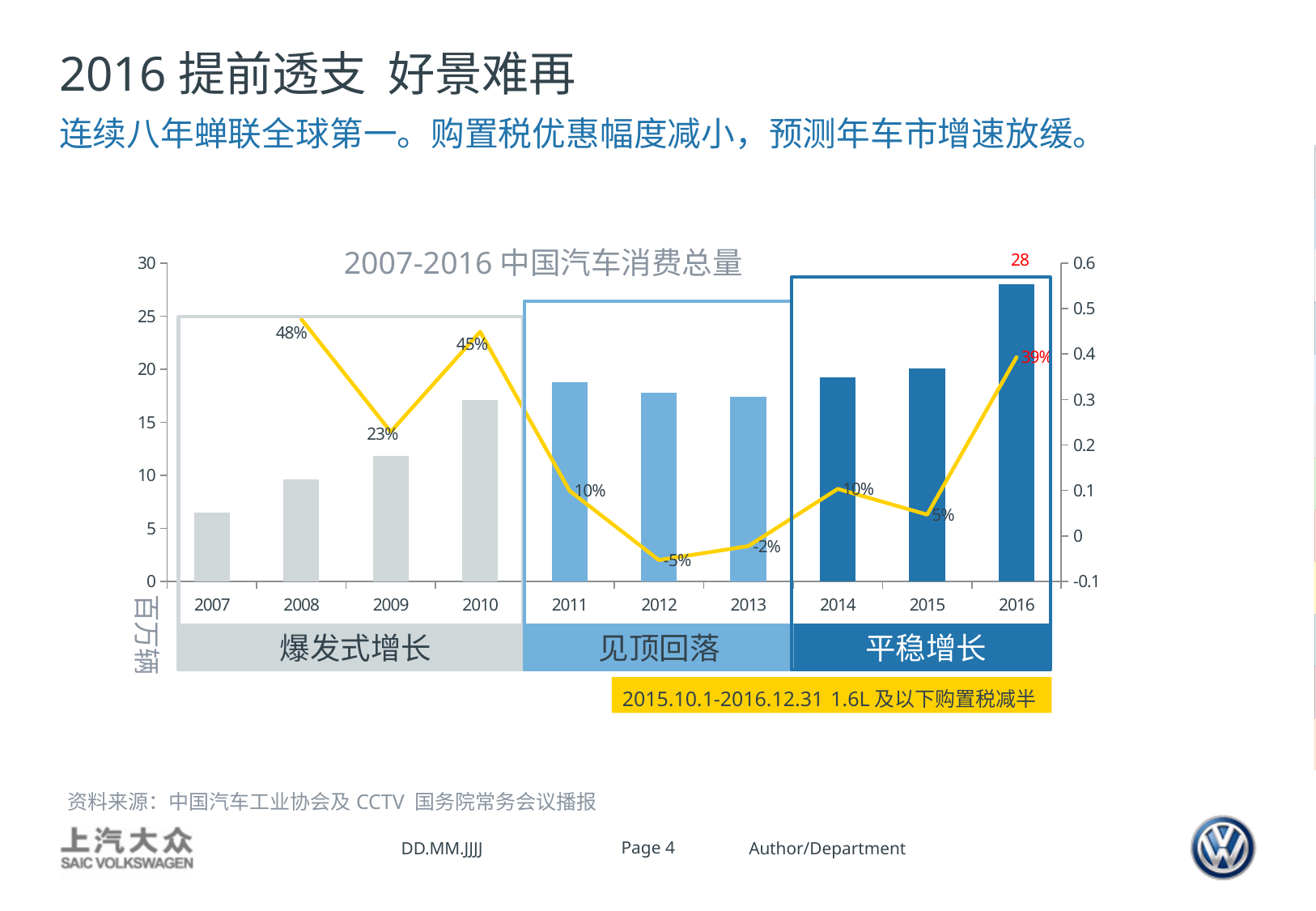
Which year has the highest growth rate on the line? 2008 Which is larger, the growth rate for 2010 or for 2011? 2010 What is the growth rate shown for 2012? -5% What is the growth rate shown for 2016? 39% Which year has the tallest bar? 2016 What is the difference between the growth rates for 2008 and 2009? 25 percentage points Is the bar value for 2007 greater or less than 10? less What value is labelled on the bar for 2016? 28 What is the title of the chart? 2007-2016 中国汽车消费总量 Which year has the lowest growth rate on the line? 2012 How many years are shown on the x axis? 10 What is the growth rate shown for 2008? 48%